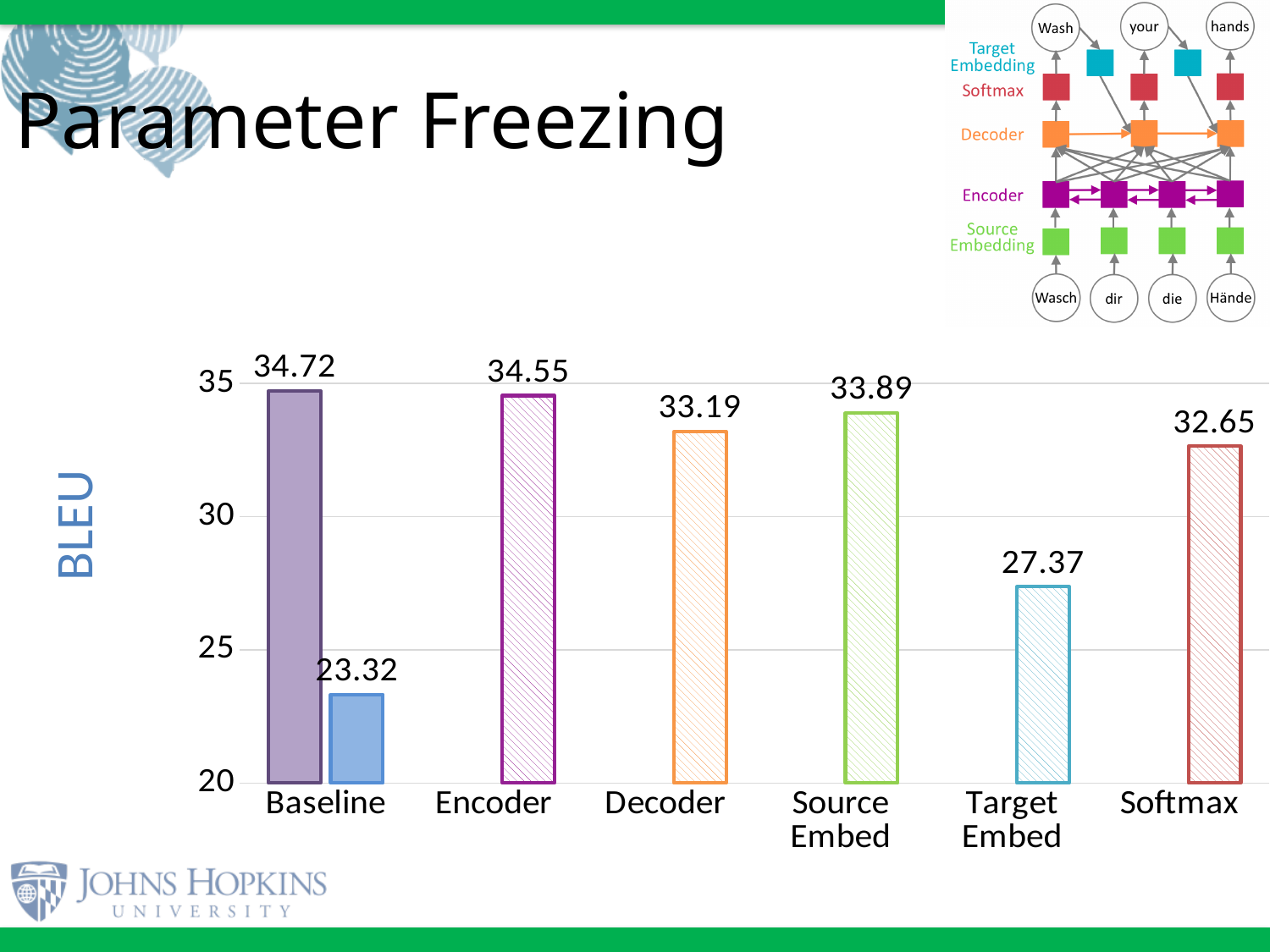
What is the BLEU value shown for the Softmax bar? 32.65 Which bar in the chart has the highest BLEU value? The taller Baseline bar (34.72) Which bar in the chart has the lowest BLEU value? The shorter Baseline bar (23.32) What is the BLEU value of the taller Baseline bar? 34.72 What is the difference in BLEU between the Source Embed bar and the Decoder bar? 0.70 What is the BLEU value shown for the Target Embed bar? 27.37 Which has a higher BLEU value, Decoder or Softmax? Decoder What kind of chart is shown on the slide? Bar chart Is the BLEU value for Target Embed greater or less than 30? less What is the BLEU value shown for the Encoder bar? 34.55 What is the BLEU value of the shorter Baseline bar? 23.32 How many category labels are shown along the x axis of the chart? 6